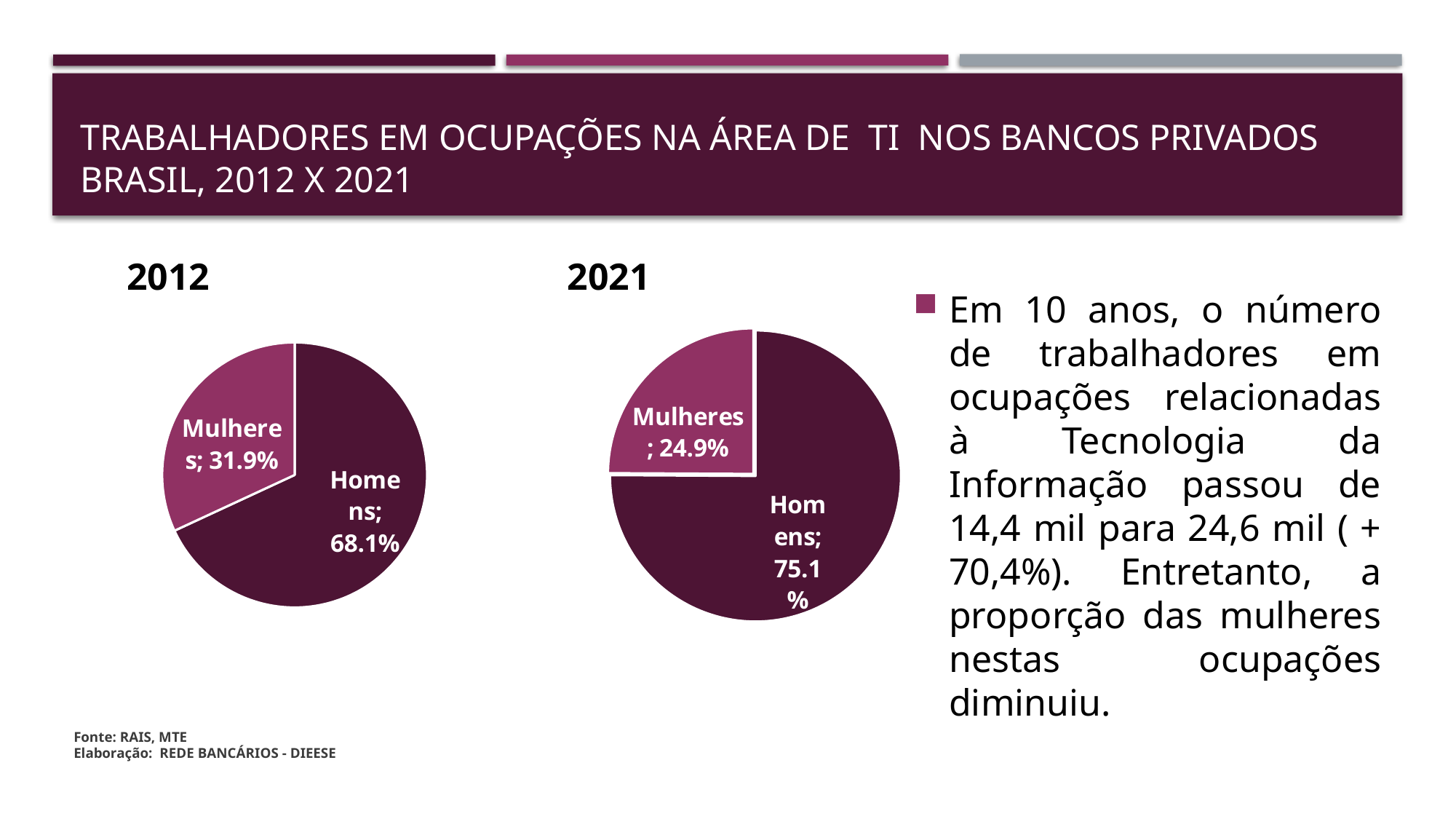
By how many percentage points did the Mulheres share fall from the 2012 pie chart to the 2021 pie chart? 7 percentage points In the 2021 pie chart, what is the share for Mulheres? 24.9% How many pie charts are shown on the slide? 2 In the 2012 pie chart, what is the share for Homens? 68.1% In the 2012 pie chart, what is the share for Mulheres? 31.9% In the 2012 pie chart, which category has the largest slice? Homens Is the Mulheres share larger in the 2012 pie chart or in the 2021 pie chart? 2012 How many slices does the 2021 pie chart have? 2 In the 2021 pie chart, which category has the smallest slice? Mulheres In the 2021 pie chart, what is the share for Homens? 75.1% In the 2012 pie chart, what is the difference between the Homens and Mulheres shares? 36.2 percentage points What kind of chart is used for the 2012 data? Pie chart